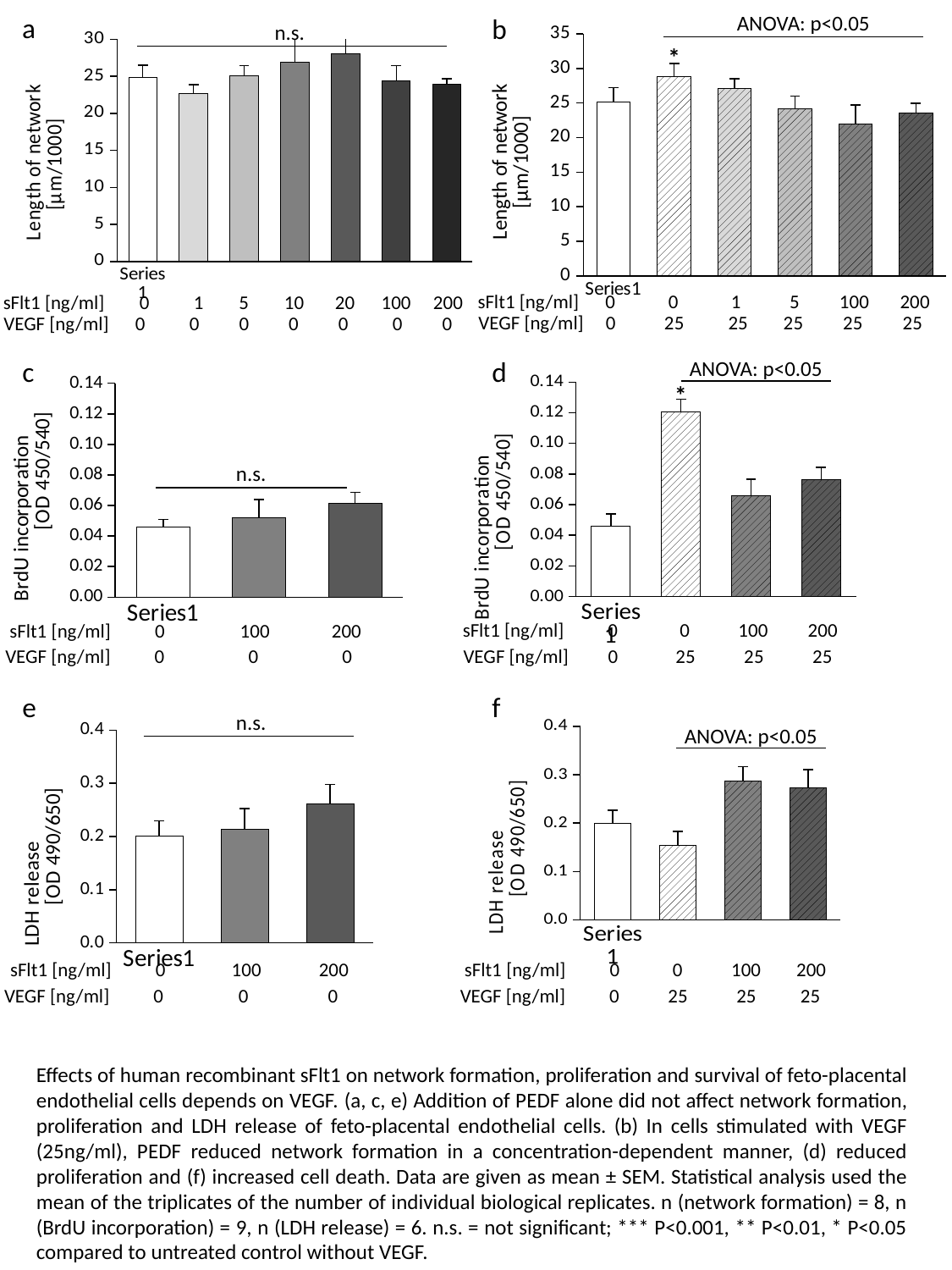
In panel c, how many bars are plotted? 3 In panel a, is the value for sFlt1 20 ng/ml greater or less than 25? greater In panel a, how many bars are plotted? 7 In panel d, which bar is the highest? sFlt1 0 ng/ml with VEGF 25 ng/ml What kind of chart is panel a? bar chart In panel f, which bar is the lowest? sFlt1 0 ng/ml with VEGF 25 ng/ml In panel d, is the value for sFlt1 0 ng/ml with VEGF 25 ng/ml greater or less than 0.10? greater In panel b, which bar is the highest? sFlt1 0 ng/ml with VEGF 25 ng/ml In panel b, is the value for sFlt1 100 ng/ml (VEGF 25) greater or less than 25? less In panel e, which bar is the highest? sFlt1 200 ng/ml What statistical annotation is printed above the bars in panel b? ANOVA: p<0.05 In panel c, do the values rise or fall as sFlt1 concentration increases? rise